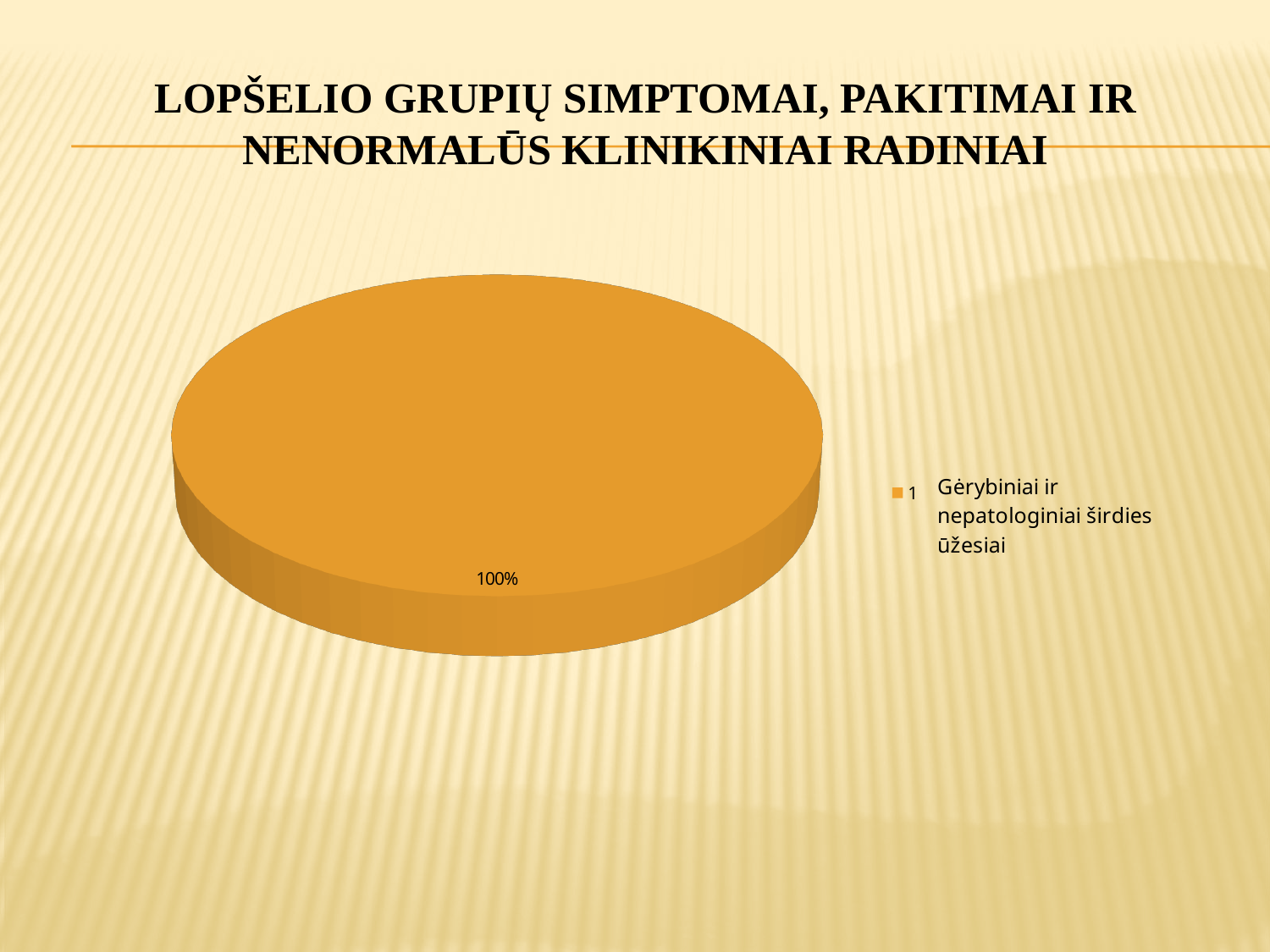
What kind of chart is shown on the slide? Pie chart What colour is the single slice of the pie chart? Orange How many entries does the legend of the pie chart list? 1 What is the legend entry shown next to the orange marker on the pie chart? Gėrybiniai ir nepatologiniai širdies ūžesiai What share of the pie does the slice for 'Gėrybiniai ir nepatologiniai širdies ūžesiai' represent? 100% What percentage is printed as the data label on the pie chart? 100% How many slices does the pie chart have? 1